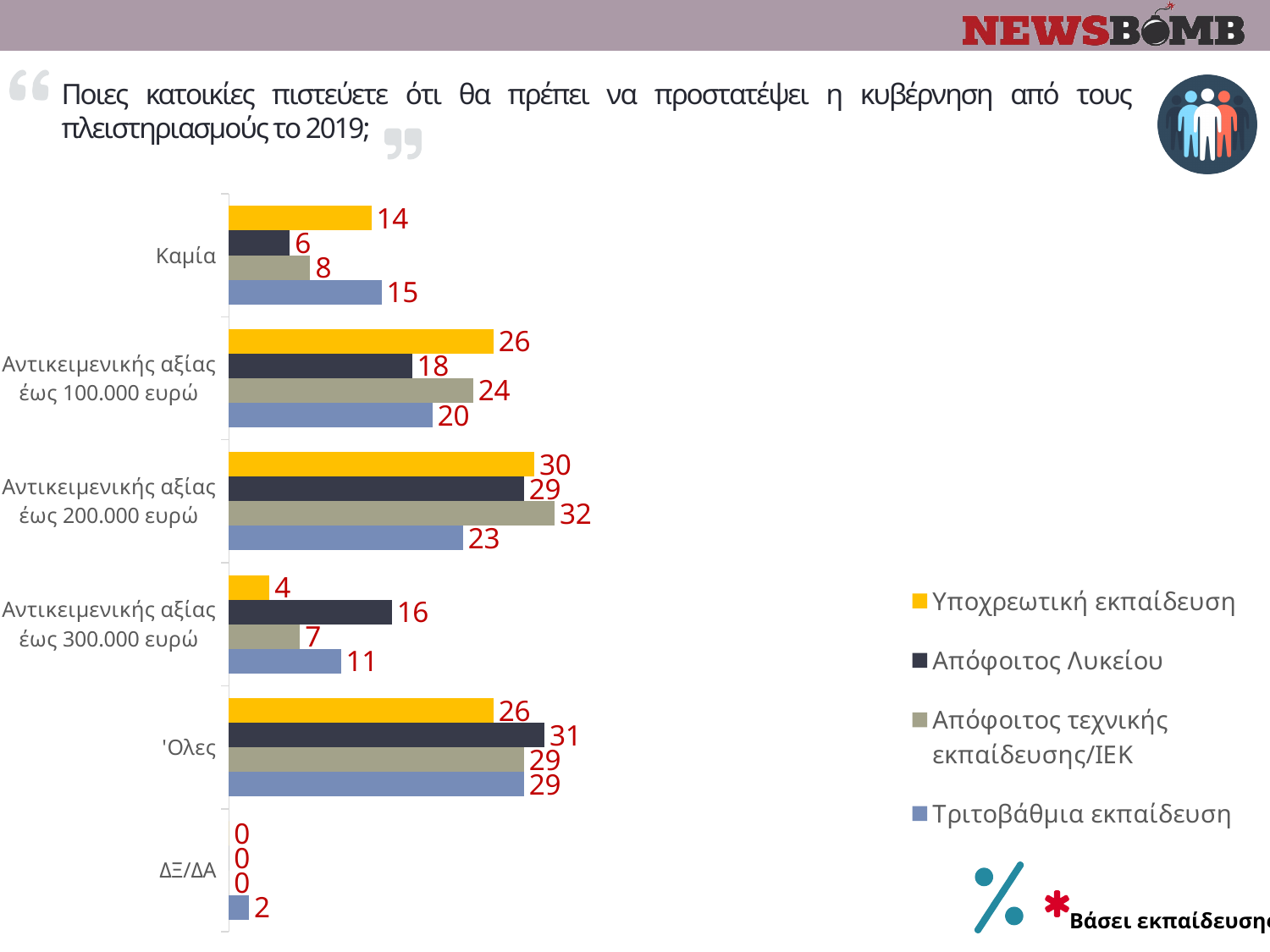
How many series does the legend list? 4 In the category Αντικειμενικής αξίας έως 100.000 ευρώ, which is larger: the value for Υποχρεωτική εκπαίδευση or for Απόφοιτος Λυκείου? Υποχρεωτική εκπαίδευση What is the value for Υποχρεωτική εκπαίδευση in the category Αντικειμενικής αξίας έως 200.000 ευρώ? 30 Which series is shown in yellow? Υποχρεωτική εκπαίδευση Which category has the highest value for Απόφοιτος τεχνικής εκπαίδευσης/ΙΕΚ? Αντικειμενικής αξίας έως 200.000 ευρώ What is the difference between the Υποχρεωτική εκπαίδευση and Απόφοιτος Λυκείου values in the category Αντικειμενικής αξίας έως 300.000 ευρώ? 12 What is the value for Απόφοιτος Λυκείου in the category Όλες? 31 Which category has the lowest value for Τριτοβάθμια εκπαίδευση? ΔΞ/ΔΑ What kind of chart is shown on the slide? Bar chart What is the value for Απόφοιτος τεχνικής εκπαίδευσης/ΙΕΚ in the category Αντικειμενικής αξίας έως 300.000 ευρώ? 7 What is the value for Τριτοβάθμια εκπαίδευση in the category Καμία? 15 How many categories are shown on the chart? 6